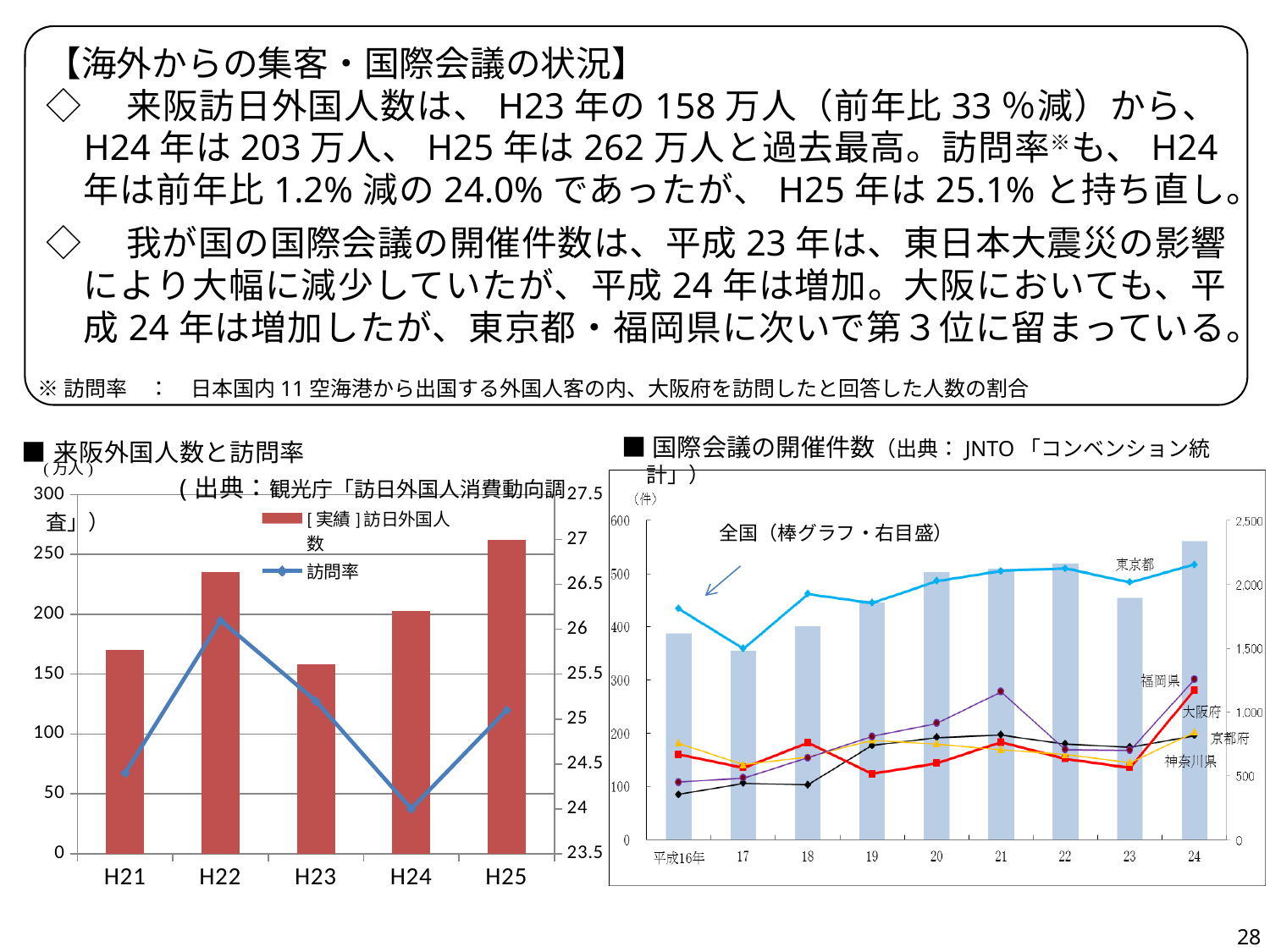
In the right chart (国際会議の開催件数), which year has the tallest 全国 bar? 24 What kind of chart is the left chart, 来阪外国人数と訪問率? A bar chart combined with a line In the left chart (来阪外国人数と訪問率), which year has the tallest bar for [実績]訪日外国人数? H25 In the right chart (国際会議の開催件数), how many years are shown on the x axis? 9 In the left chart (来阪外国人数と訪問率), in which year does the 訪問率 line reach its lowest point? H24 In the left chart (来阪外国人数と訪問率), is the bar for H25 greater or less than 250? greater In the left chart (来阪外国人数と訪問率), how many series does the legend list? 2 In the left chart (来阪外国人数と訪問率), does the 訪問率 line rise or fall from H22 to H24? fall In the left chart (来阪外国人数と訪問率), how many years are shown on the x axis? 5 In the left chart (来阪外国人数と訪問率), which year has the shortest bar for [実績]訪日外国人数? H23 In the left chart (来阪外国人数と訪問率), which bar is taller, H22 or H24? H22 In the right chart (国際会議の開催件数), which prefecture's line is the highest across all years? 東京都